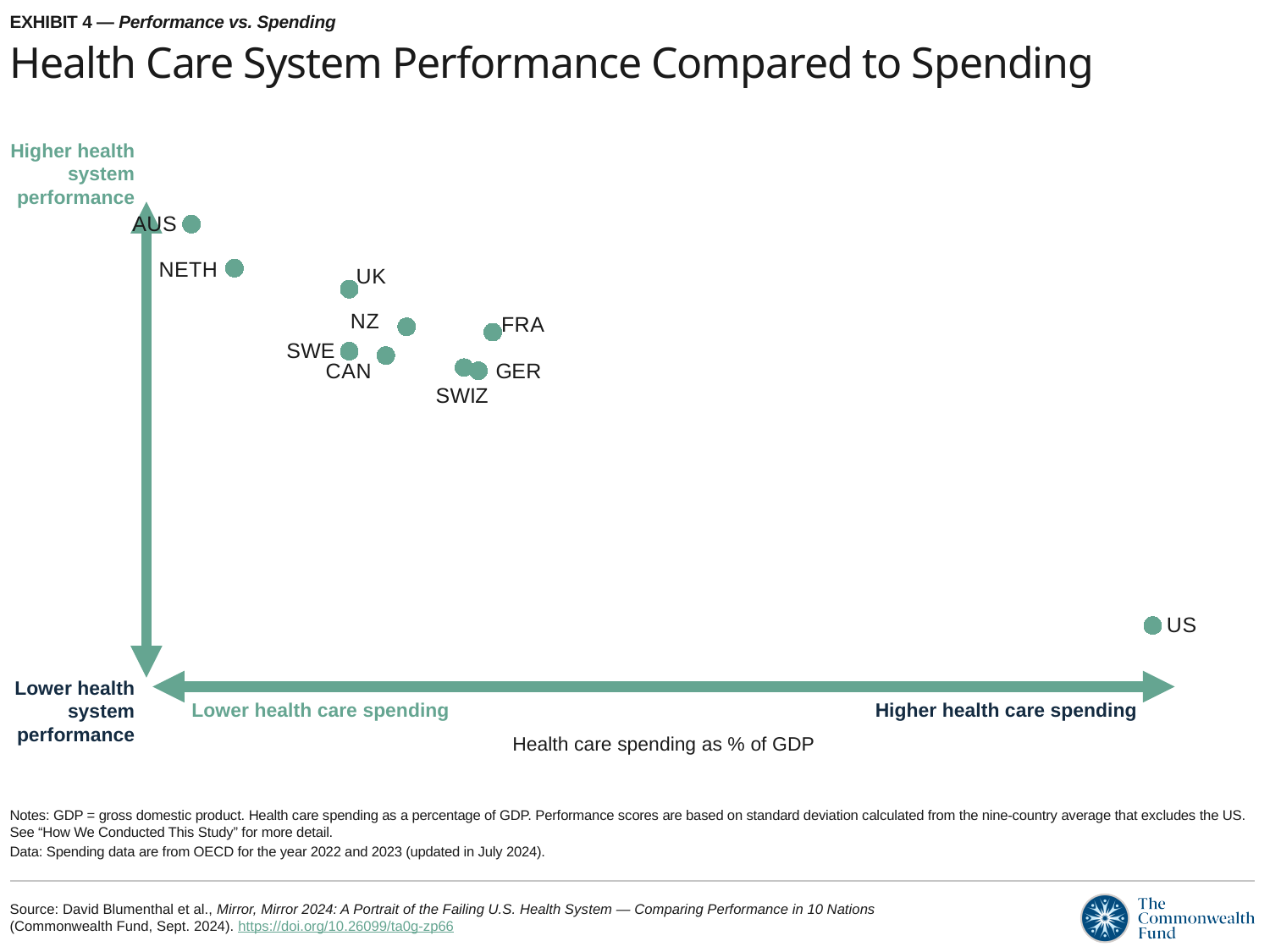
Which country has the lowest health system performance on the chart? US What does the horizontal axis of the chart represent? Health care spending as % of GDP Which country has the lowest health care spending as % of GDP on the chart? AUS Which country has the highest health care spending as % of GDP on the chart? US What is the title of the chart? Health Care System Performance Compared to Spending Which country has higher health care spending as % of GDP, US or AUS? US Which country has higher health system performance, NETH or UK? NETH Which country has the highest health system performance on the chart? AUS Which country has higher health system performance, US or GER? GER What kind of chart is shown on the slide? Scatter plot How many countries are plotted on the chart? 10